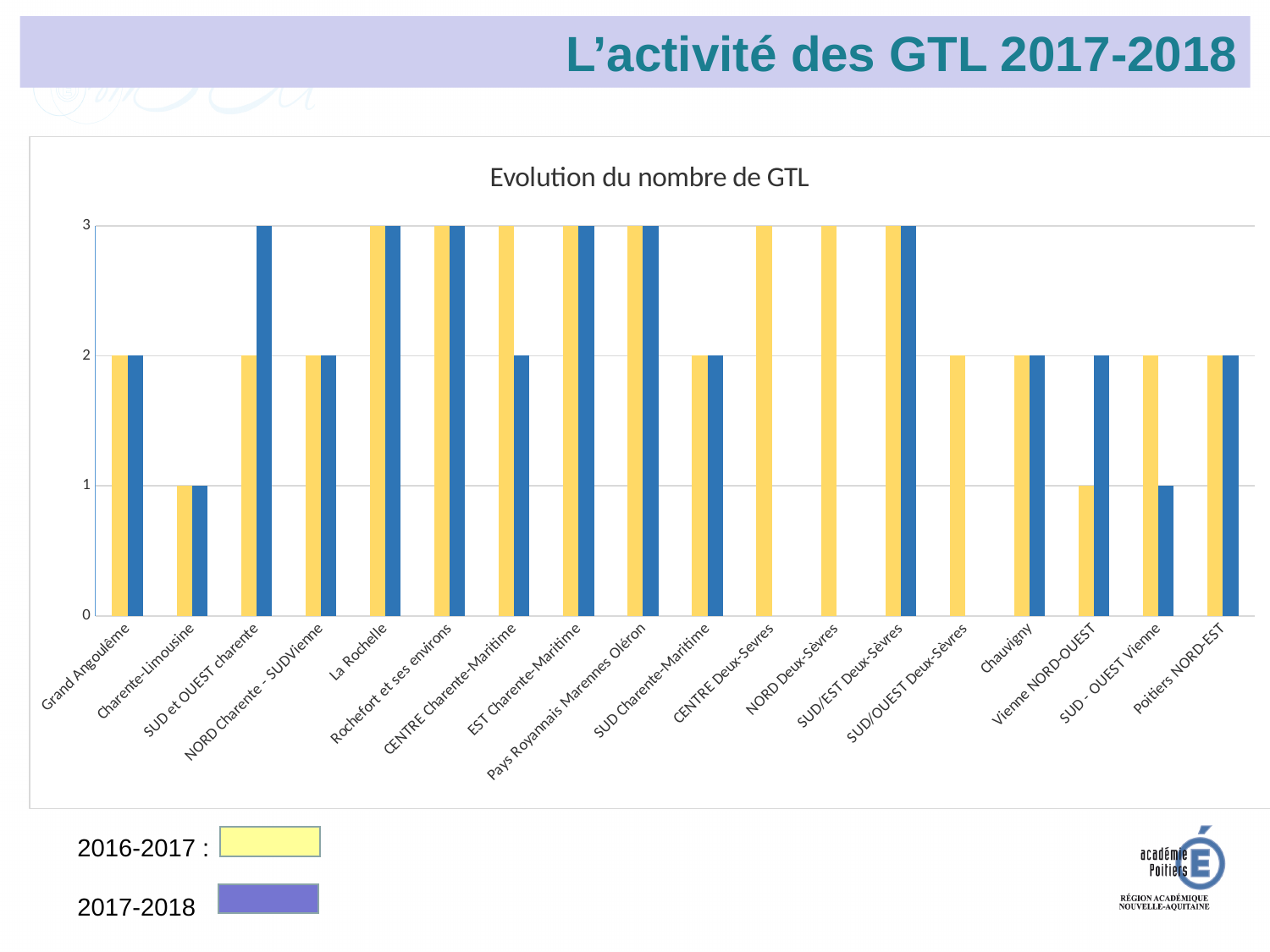
Which colour represents the 2017-2018 series? blue What is the value for La Rochelle in 2016-2017? 3 How many categories are shown on the x axis of the chart? 18 What is the title of the chart? Evolution du nombre de GTL What is the value for SUD et OUEST charente in 2017-2018? 3 For SUD - OUEST Vienne, which is larger: the 2016-2017 value or the 2017-2018 value? 2016-2017 What is the difference between the 2016-2017 and 2017-2018 values for CENTRE Charente-Maritime? 1 What type of chart is shown on the slide? bar chart How many series does the legend list? 2 What is the value for Vienne NORD-OUEST in 2016-2017? 1 What is the value for Charente-Limousine in 2017-2018? 1 For SUD et OUEST charente, which is larger: the 2016-2017 value or the 2017-2018 value? 2017-2018